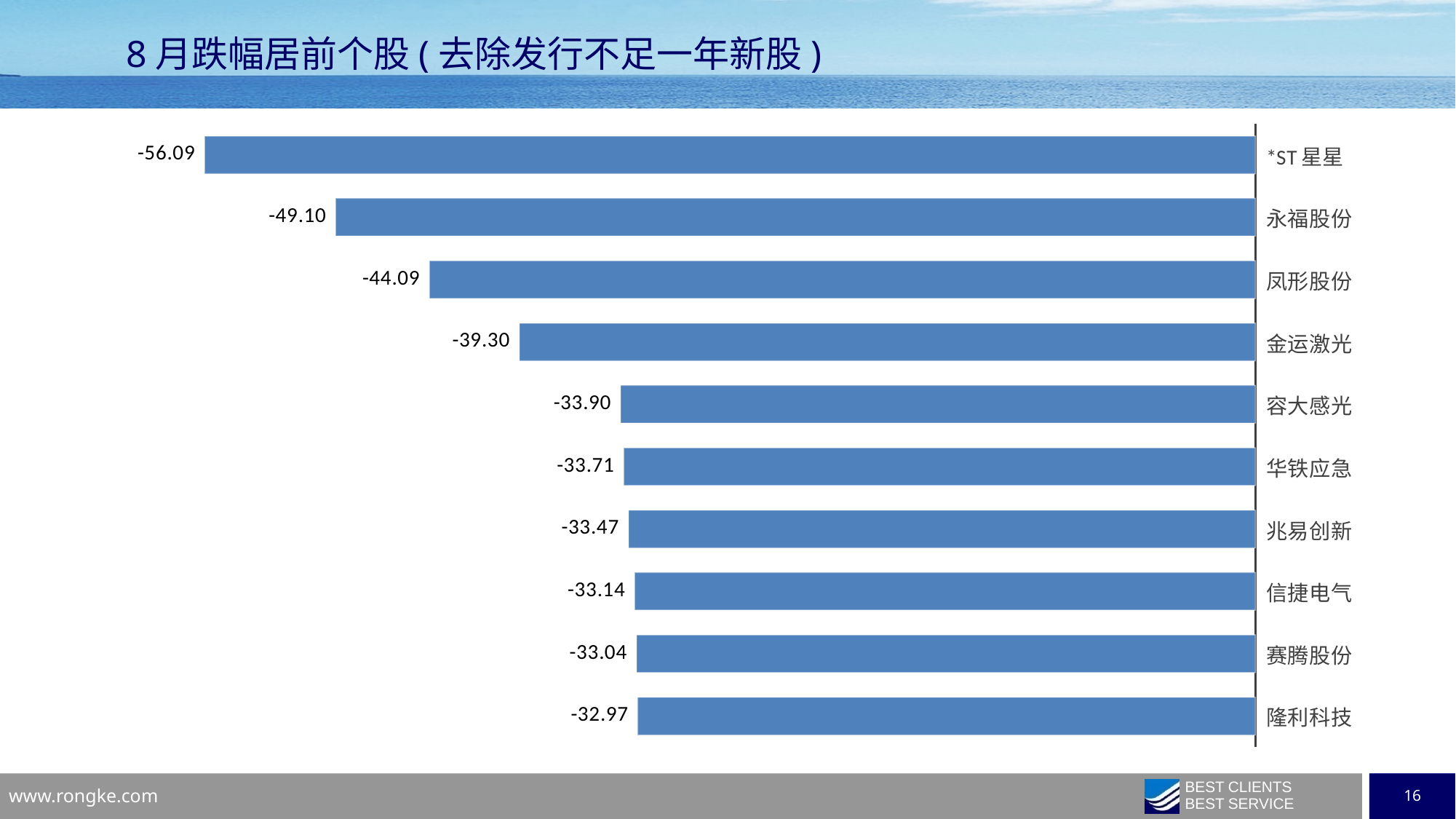
What is the value shown for 金运激光? -39.30 What is the value shown for 兆易创新? -33.47 What is the value shown for 隆利科技? -32.97 What is the difference between the values for 凤形股份 and 金运激光? 4.79 What kind of chart is shown on the slide? Bar chart What is the value shown for *ST 星星? -56.09 How many stocks are shown on the chart? 10 Which stock has the highest value (smallest decline) on the chart? 隆利科技 What is the difference between the values for *ST 星星 and 永福股份? 6.99 Which has a larger decline, 永福股份 or 容大感光? 永福股份 Which stock has the lowest value (largest decline) on the chart? *ST 星星 What is the title of the slide? 8 月跌幅居前个股 ( 去除发行不足一年新股 )